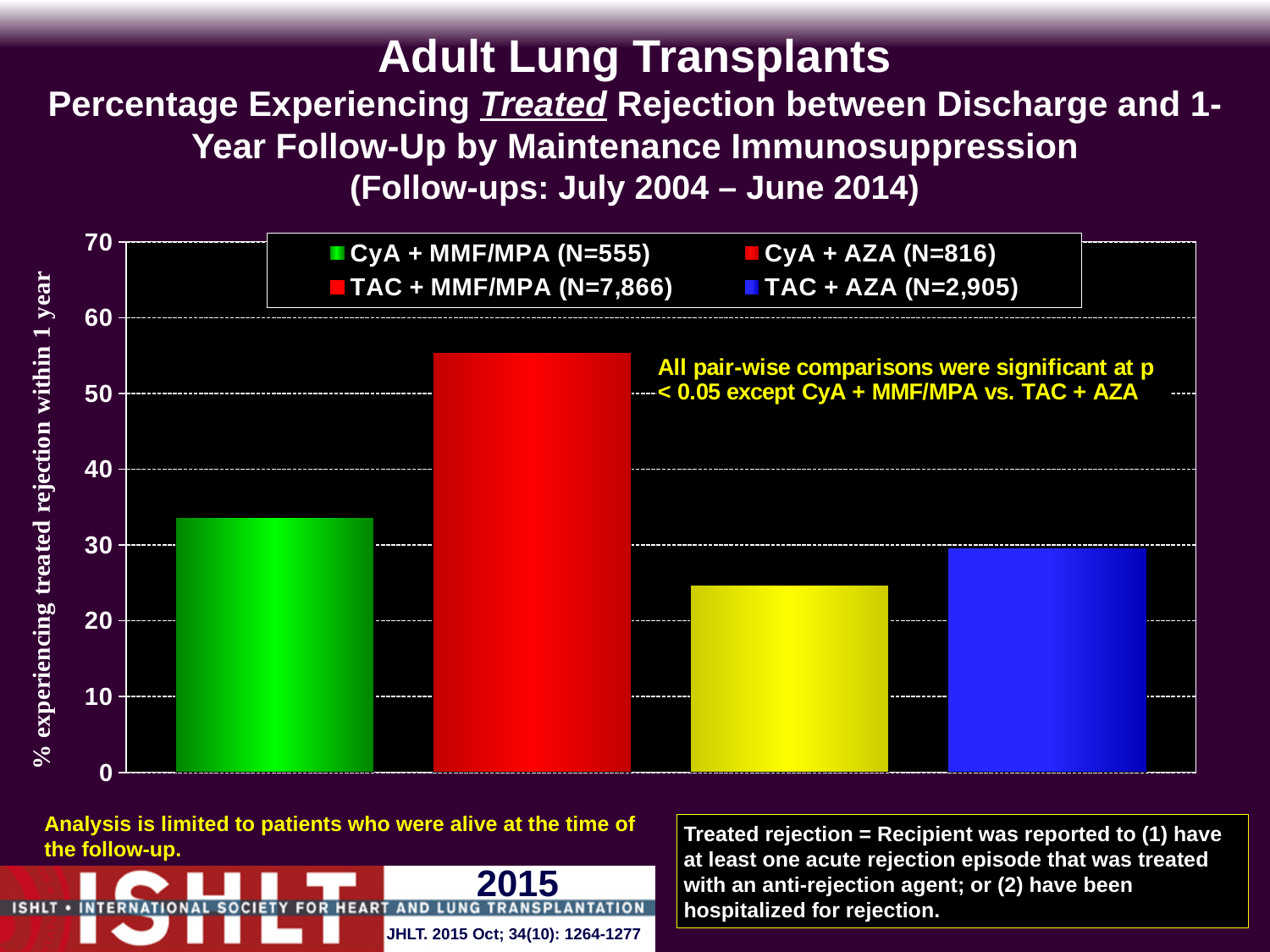
Is the value for CyA + AZA greater or less than 50? greater Which maintenance immunosuppression group has the highest percentage experiencing treated rejection? CyA + AZA What kind of chart is shown on the slide? bar chart Which maintenance immunosuppression group has the lowest percentage experiencing treated rejection? TAC + MMF/MPA Is the value for CyA + AZA greater or less than 60? less What is the sample size (N) shown in the legend for the TAC + MMF/MPA group? 7,866 Is the value for TAC + MMF/MPA greater or less than 30? less What is the label on the y axis of the chart? % experiencing treated rejection within 1 year How many bars are plotted in the chart? 4 How many series does the legend list? 4 Which is larger, the value for CyA + AZA or the value for TAC + MMF/MPA? CyA + AZA